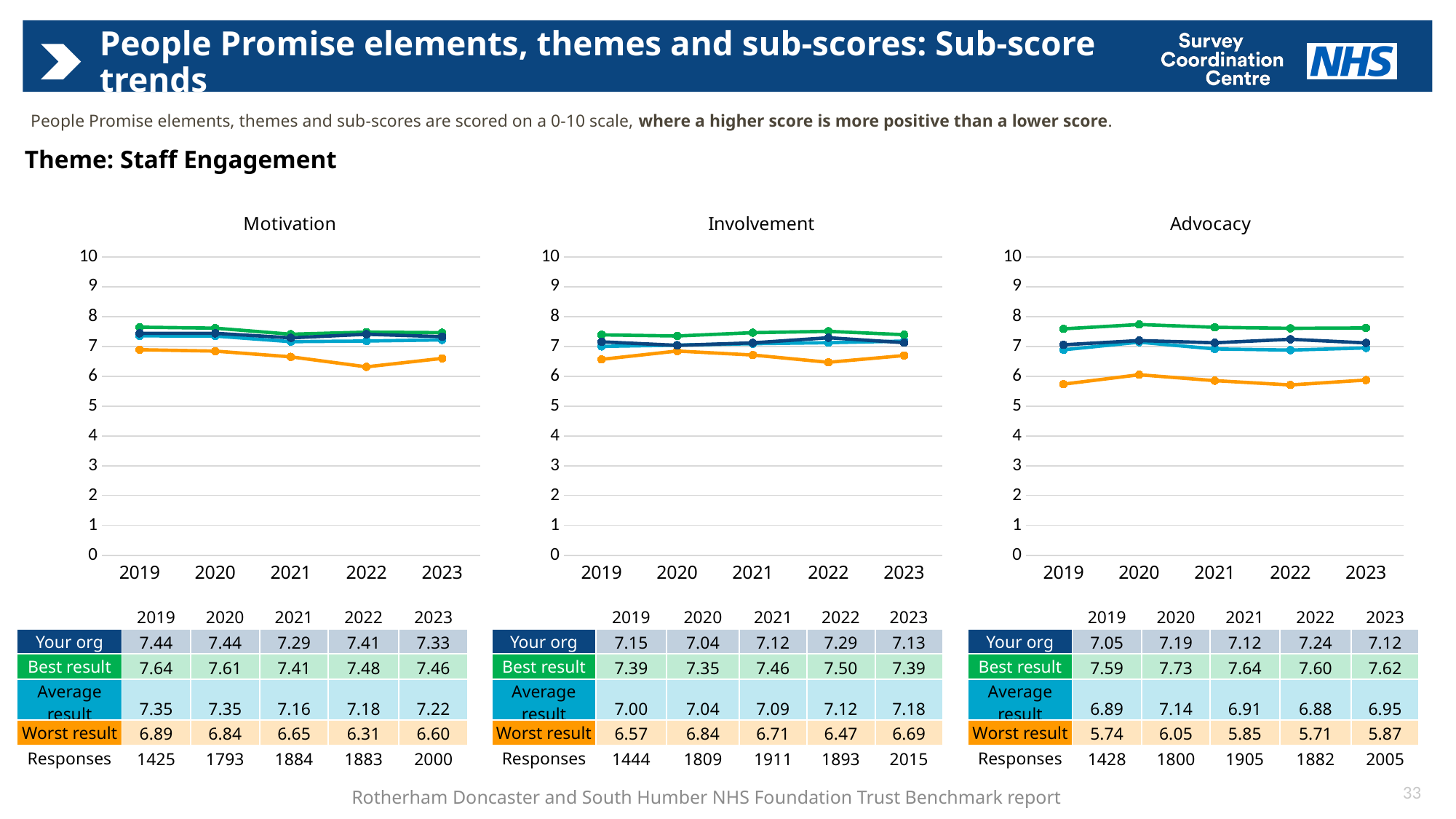
In the Advocacy chart, what is the Worst result value for 2020? 6.05 In the Involvement chart, does the Average result series rise or fall from 2019 to 2023? rise In the Motivation chart, is the Worst result value for 2022 greater or less than 7? less How many series are plotted in the Advocacy chart? 4 In the Involvement chart, what is the Best result value for 2021? 7.46 In the Involvement chart, what is the difference between the Best result and Your org values in 2019? 0.24 In the Motivation chart, what is the Your org value for 2022? 7.41 How many years are plotted on the x axis of the Involvement chart? 5 What kind of chart is the Motivation chart? line chart In the Advocacy chart, which year has the highest Best result value? 2020 In the Motivation chart, which year has the lowest Worst result value? 2022 In the Advocacy chart, is the Your org value for 2022 larger or smaller than the Average result value for 2022? larger